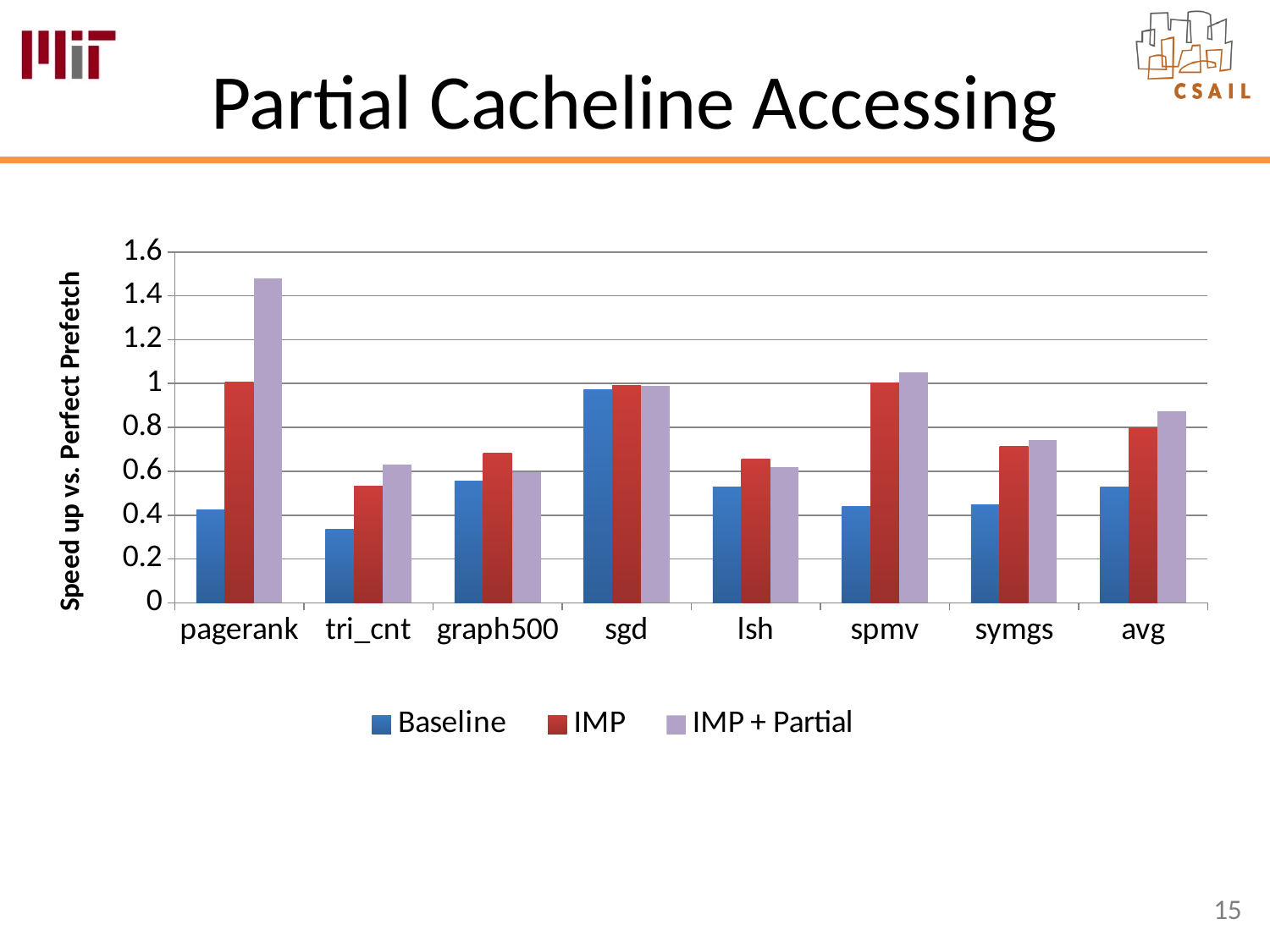
What kind of chart is shown on the slide? bar chart For graph500, which is larger: the IMP value or the IMP + Partial value? IMP How many categories are shown along the x axis? 8 Which category has the highest Baseline value? sgd Is the IMP value for avg greater or less than 0.6? greater Is the IMP + Partial value for pagerank greater or less than 1.2? greater What is the label on the y axis? Speed up vs. Perfect Prefetch Which category has the lowest Baseline value? tri_cnt How many series does the legend list? 3 Which category has the highest IMP + Partial value? pagerank Is the Baseline value for tri_cnt greater or less than 0.4? less For spmv, which is larger: the Baseline value or the IMP + Partial value? IMP + Partial